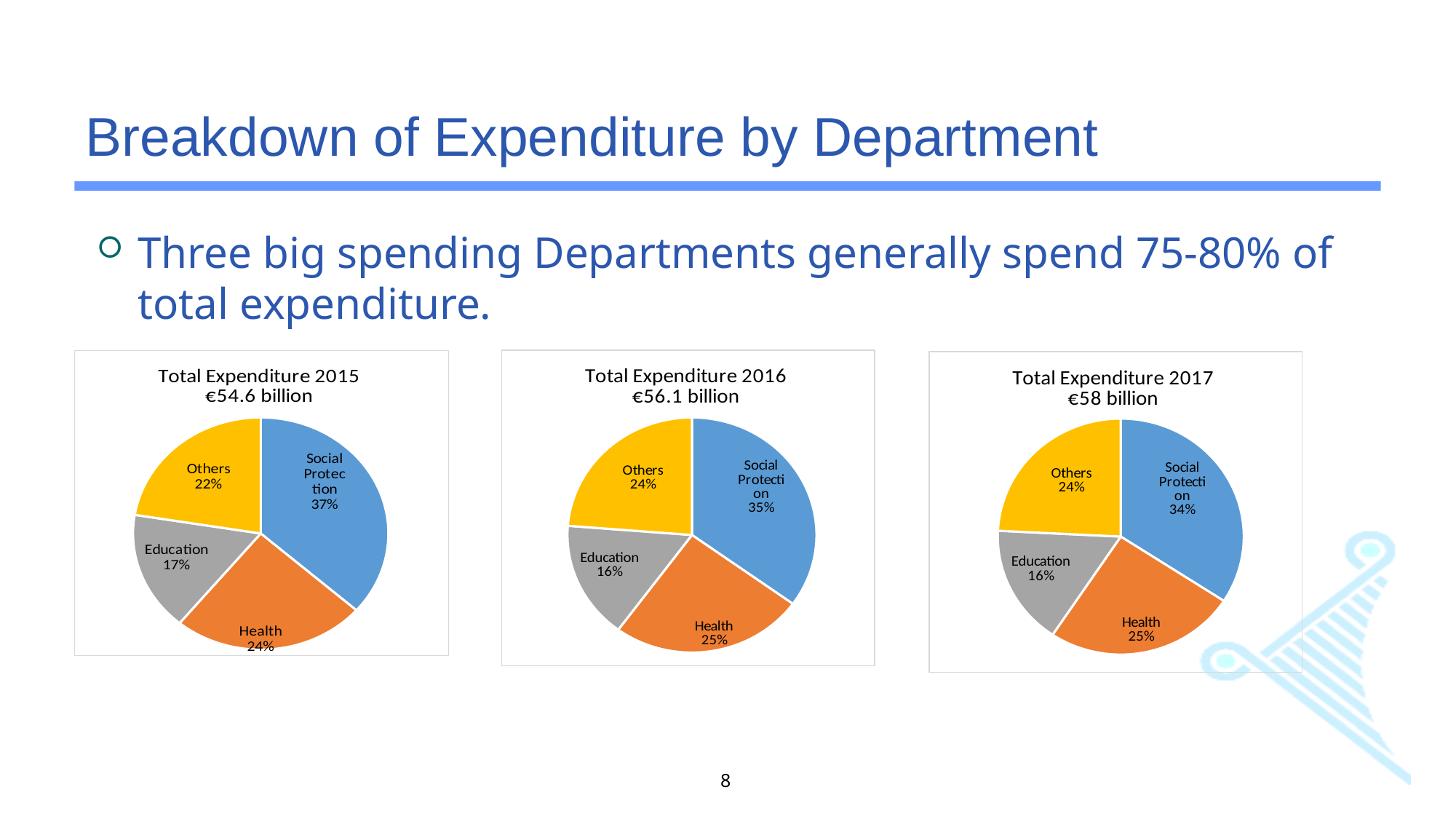
In the Total Expenditure 2015 chart, what share does Social Protection have? 37% In the Total Expenditure 2015 chart, what colour is the Others slice? Yellow In the Total Expenditure 2017 chart, what is the combined share of Social Protection, Health and Education? 75% In the Total Expenditure 2017 chart, which category has the smallest slice? Education What total expenditure figure is shown in the title of the Total Expenditure 2017 chart? €58 billion In the Total Expenditure 2016 chart, what is the difference in percentage points between Social Protection and Others? 11 In the Total Expenditure 2016 chart, what share does Education have? 16% How many slices does the Total Expenditure 2017 chart have? 4 In the Total Expenditure 2015 chart, which category has the largest slice? Social Protection In the Total Expenditure 2017 chart, what share does Health have? 25% In the Total Expenditure 2015 chart, which is larger, Health or Education? Health What kind of chart is the Total Expenditure 2016 chart? Pie chart